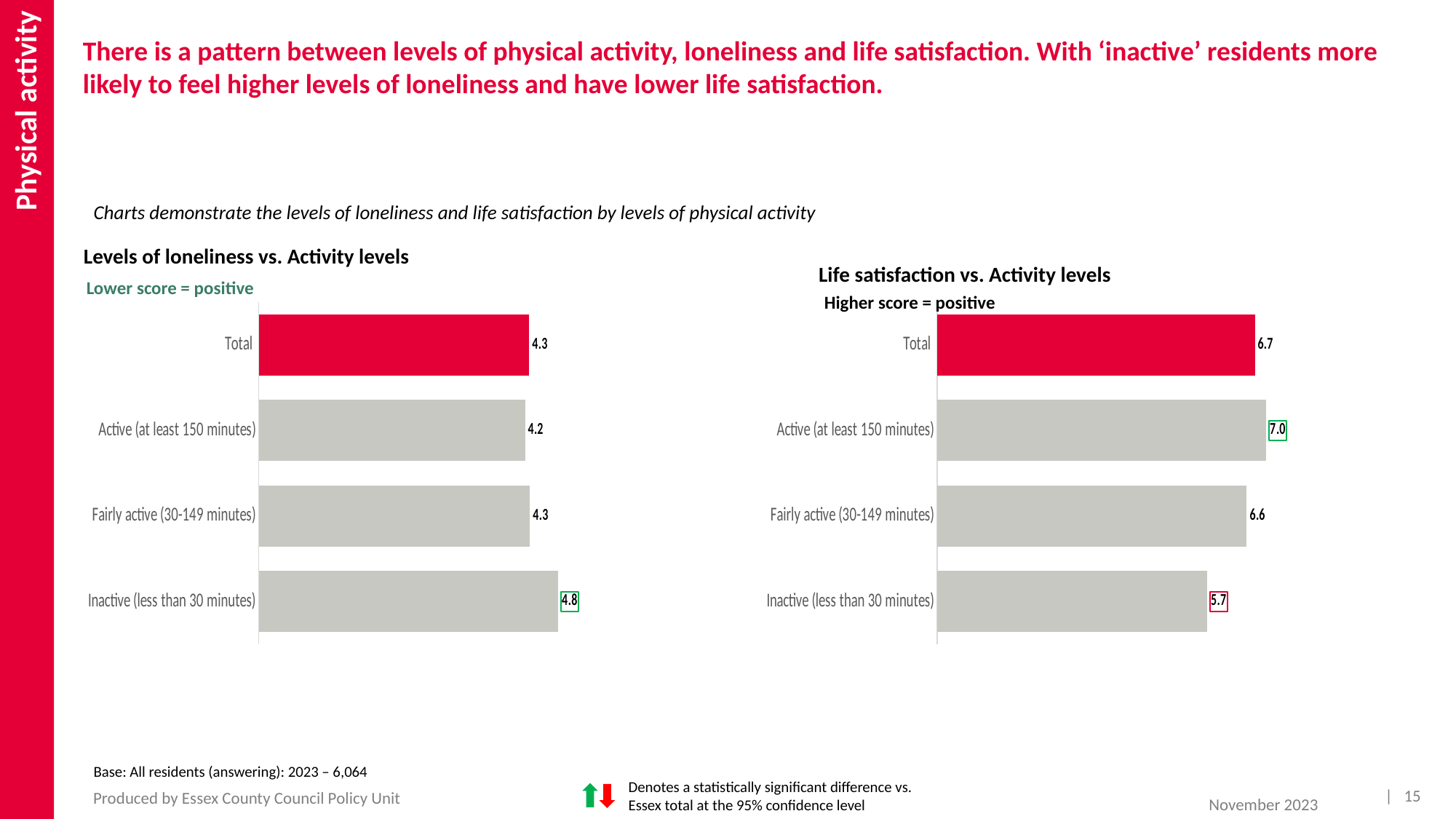
In the 'Life satisfaction vs. Activity levels' chart, which category has the lowest value? Inactive (less than 30 minutes) In the 'Levels of loneliness vs. Activity levels' chart, which category has the highest value? Inactive (less than 30 minutes) In the 'Levels of loneliness vs. Activity levels' chart, what is the value for Inactive (less than 30 minutes)? 4.8 In the 'Life satisfaction vs. Activity levels' chart, which is larger: the value for Total or the value for Fairly active (30-149 minutes)? Total In the 'Levels of loneliness vs. Activity levels' chart, what is the value for Total? 4.3 What kind of chart is the 'Life satisfaction vs. Activity levels' chart? Bar chart In the 'Life satisfaction vs. Activity levels' chart, what is the value for Inactive (less than 30 minutes)? 5.7 In the 'Levels of loneliness vs. Activity levels' chart, what is the difference between the values for Inactive (less than 30 minutes) and Active (at least 150 minutes)? 0.6 In the 'Life satisfaction vs. Activity levels' chart, what is the value for Active (at least 150 minutes)? 7.0 How many categories are shown in the 'Levels of loneliness vs. Activity levels' chart? 4 In the 'Levels of loneliness vs. Activity levels' chart, what does the note under the title say about the score? Lower score = positive In the 'Life satisfaction vs. Activity levels' chart, what is the difference between the values for Active (at least 150 minutes) and Inactive (less than 30 minutes)? 1.3